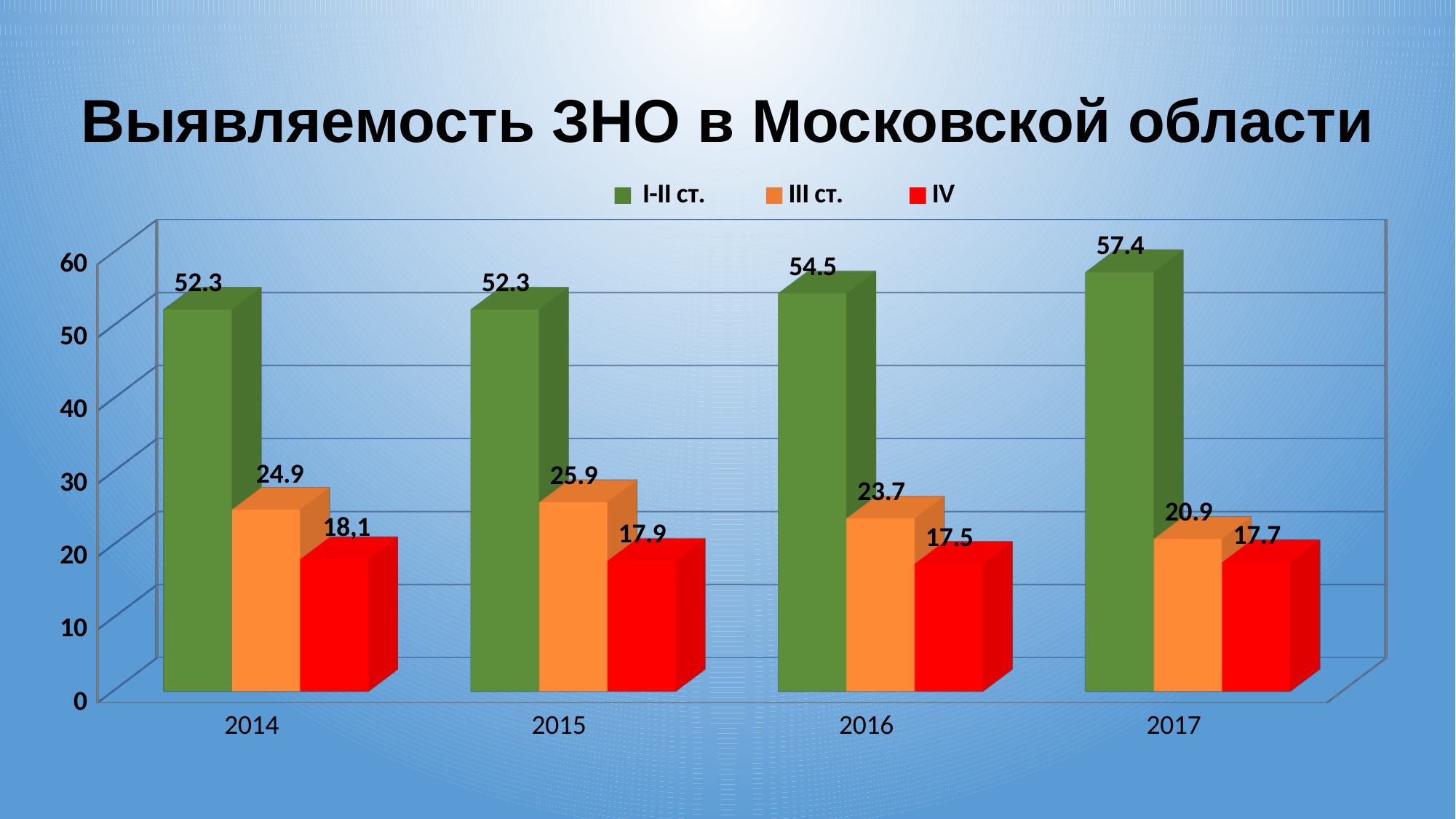
How many series does the legend list? 3 What is the difference between the I-II ст. values for 2017 and 2016? 2.9 Which is larger, the III ст. value in 2014 or in 2016? 2014 What is the value for IV in 2014? 18,1 What is the value for I-II ст. in 2017? 57.4 In which year is the III ст. value lowest? 2017 What is the title of the chart? Выявляемость ЗНО в Московской области In which year is the I-II ст. value highest? 2017 What is the value for IV in 2016? 17.5 What kind of chart is shown on the slide? bar chart What is the value for III ст. in 2015? 25.9 How many years are shown on the x axis? 4